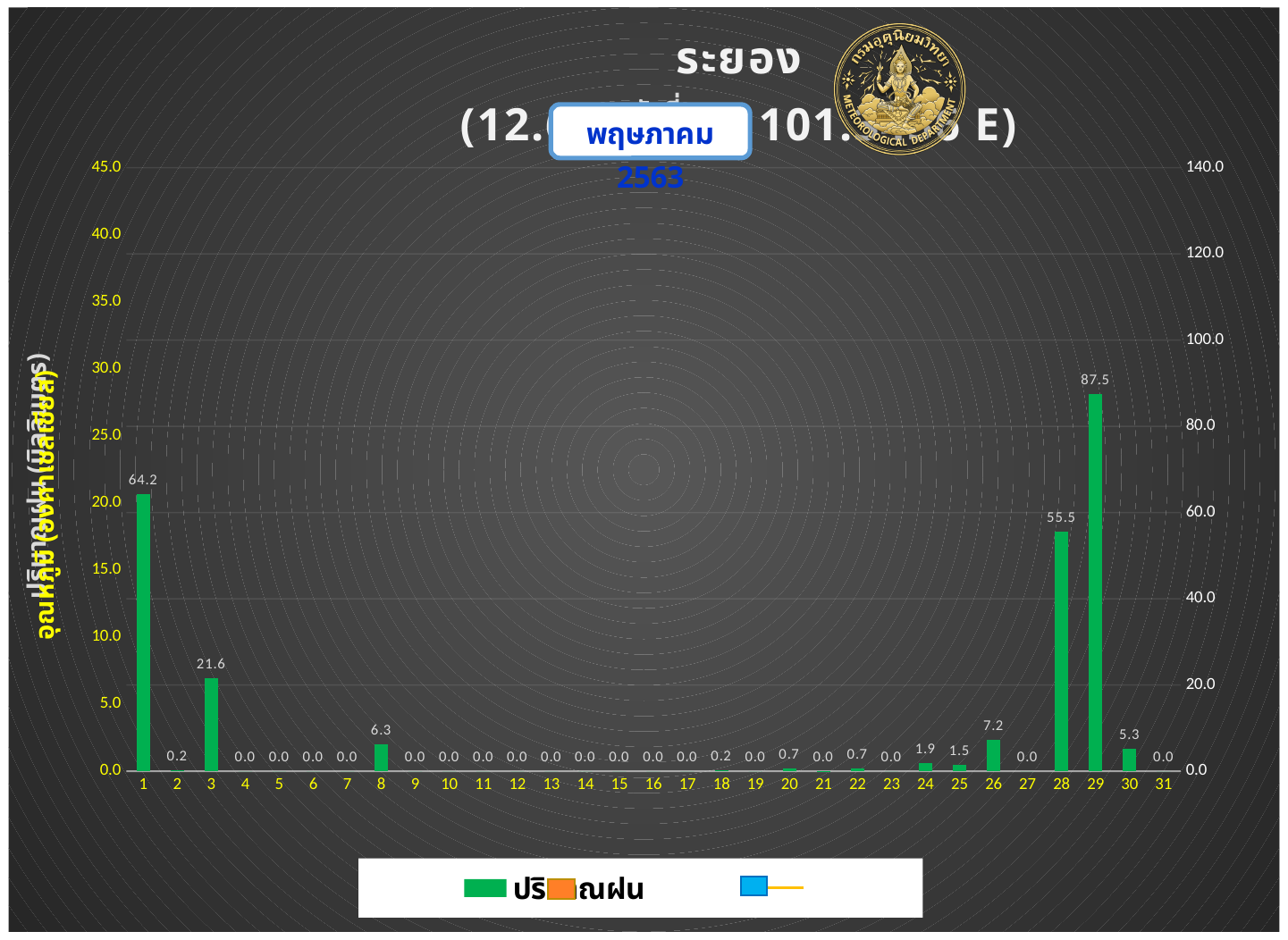
Which is larger, the rainfall value for day 8 or for day 26? day 26 What is the difference between the rainfall values for day 1 and day 3? 42.6 What is the rainfall value shown for day 29? 87.5 Which day has the highest rainfall value? 29 What is the rainfall value shown for day 1? 64.2 What is the difference between the rainfall values for day 29 and day 28? 32.0 What is the rainfall value shown for day 26? 7.2 What is the rainfall value shown for day 30? 5.3 What is the rainfall value shown for day 28? 55.5 What kind of chart is shown on the slide? bar chart What is the rainfall value shown for day 3? 21.6 How many days (categories) are shown on the x axis? 31